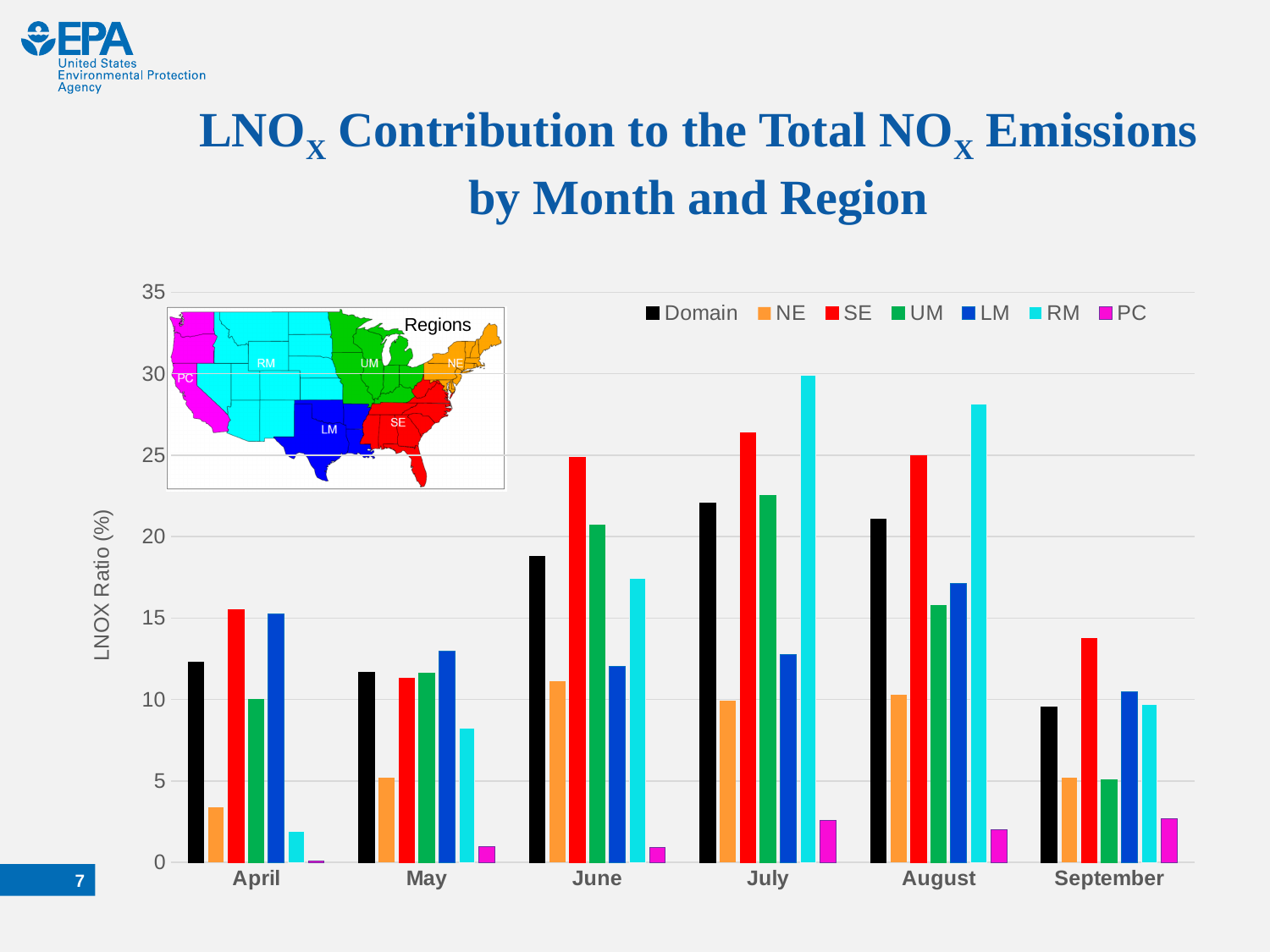
Does the RM value rise or fall from April to July? rise Which series has the lowest LNOX ratio in April? PC Which region has the highest LNOX ratio in July? RM Is the value for Domain in April greater or less than 15? less What is the label of the y axis? LNOX Ratio (%) In June, which is larger, the value for SE or the value for LM? SE What kind of chart is shown on the slide? bar chart Is the value for PC in September greater or less than 5? less Is the value for RM in July greater or less than 25? greater How many months are shown on the x axis? 6 How many series does the legend list? 7 In which month is the SE value highest? July